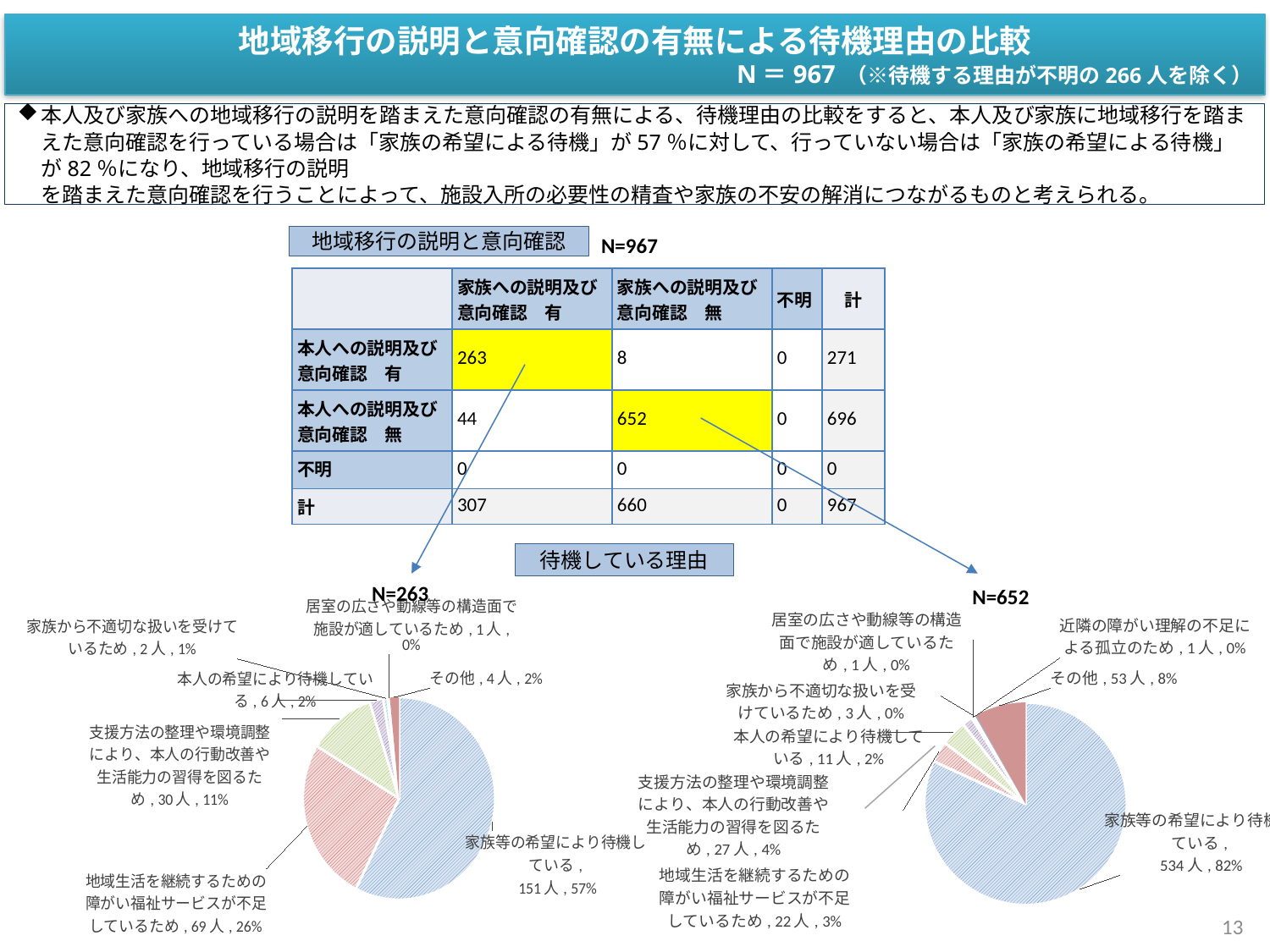
How many slices does the left pie chart (N=263) have? 7 In the right pie chart (N=652), what share of the pie is 「家族等の希望により待機している」? 82% In the left pie chart (N=263), how many people are in the 「家族等の希望により待機している」 slice? 151人 What type of chart is used to show 「待機している理由」 on this slide? Pie chart In the right pie chart (N=652), which is larger: 「支援方法の整理や環境調整により、本人の行動改善や生活能力の習得を図るため」 or 「地域生活を継続するための障がい福祉サービスが不足しているため」? 支援方法の整理や環境調整により、本人の行動改善や生活能力の習得を図るため In the left pie chart (N=263), what is the difference in people between 「家族等の希望により待機している」 and 「地域生活を継続するための障がい福祉サービスが不足しているため」? 82人 In the right pie chart (N=652), how many people are in the 「その他」 slice? 53人 In the right pie chart (N=652), which category has the largest slice? 家族等の希望により待機している In the left pie chart (N=263), which category has the largest slice? 家族等の希望により待機している How many slices does the right pie chart (N=652) have? 8 In the right pie chart (N=652), how many people are in the 「本人の希望により待機している」 slice? 11人 In the left pie chart (N=263), what share of the pie is 「地域生活を継続するための障がい福祉サービスが不足しているため」? 26%